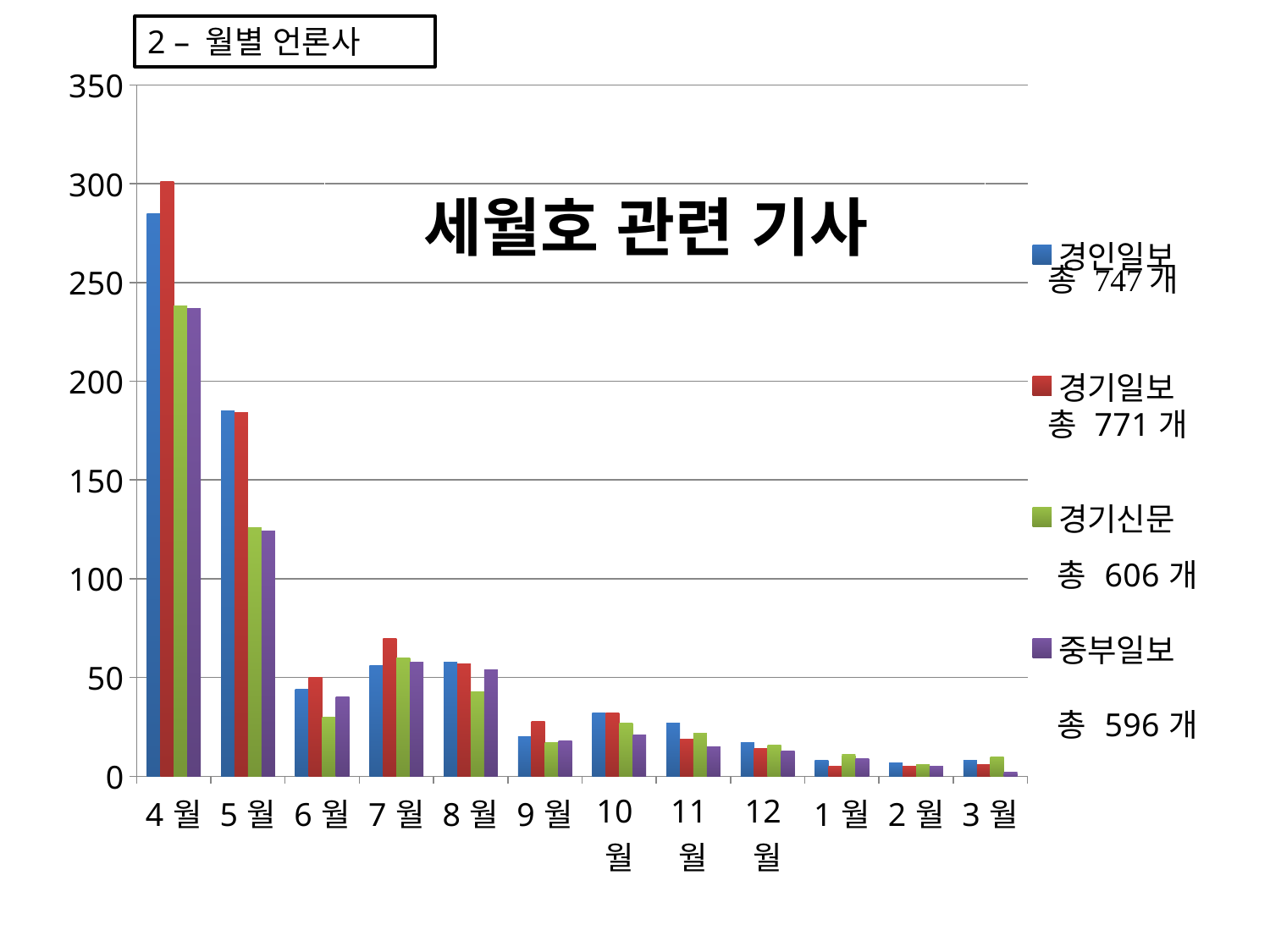
Is the value for 경인일보 in 5 월 greater or less than 150? greater According to the legend, what is the total number of articles for 경기일보? 총 771 개 Is the value for 경기신문 in 6 월 greater or less than 50? less Is the value for 경기신문 in 4 월 greater or less than 200? greater In 4 월, which is larger: 경기일보 or 경기신문? 경기일보 How many months are shown on the x axis? 12 How many series does the legend list? 4 In which month are the bars highest for all series? 4 월 What kind of chart is shown on the slide? bar chart What is the title of the chart? 세월호 관련 기사 Do the values for 경인일보 generally rise or fall from 4 월 to 9 월? fall